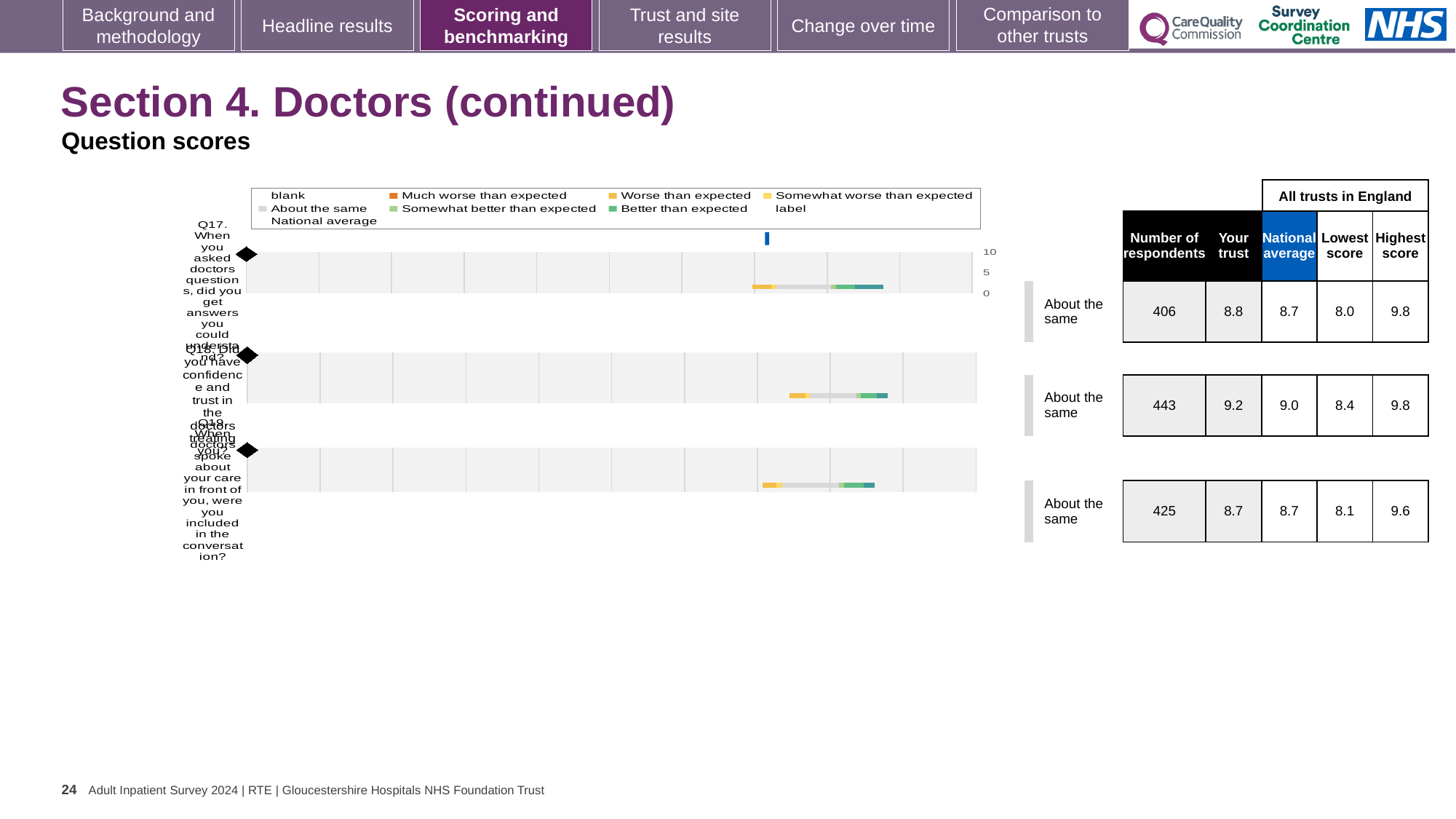
Which question has the lowest 'Your trust' score in the table beside the chart? Q19 What is the difference in number of respondents between Q18 and Q17? 37 According to the table beside the chart, what is the national average for Q17? 8.7 Which question has the highest 'Your trust' score in the table beside the chart? Q18 What is the highest value shown on the chart's axis? 10 Which has more respondents, Q18 or Q19? Q18 How many entries does the chart legend list? 9 How many questions (categories) are plotted in the chart? 3 What kind of chart is shown on the slide? bar chart What benchmark category is shown for all three questions on the slide? About the same According to the table beside the chart, what is the 'Your trust' score for Q18 (confidence and trust in doctors)? 9.2 What is the difference between the 'Your trust' scores for Q18 and Q17? 0.4